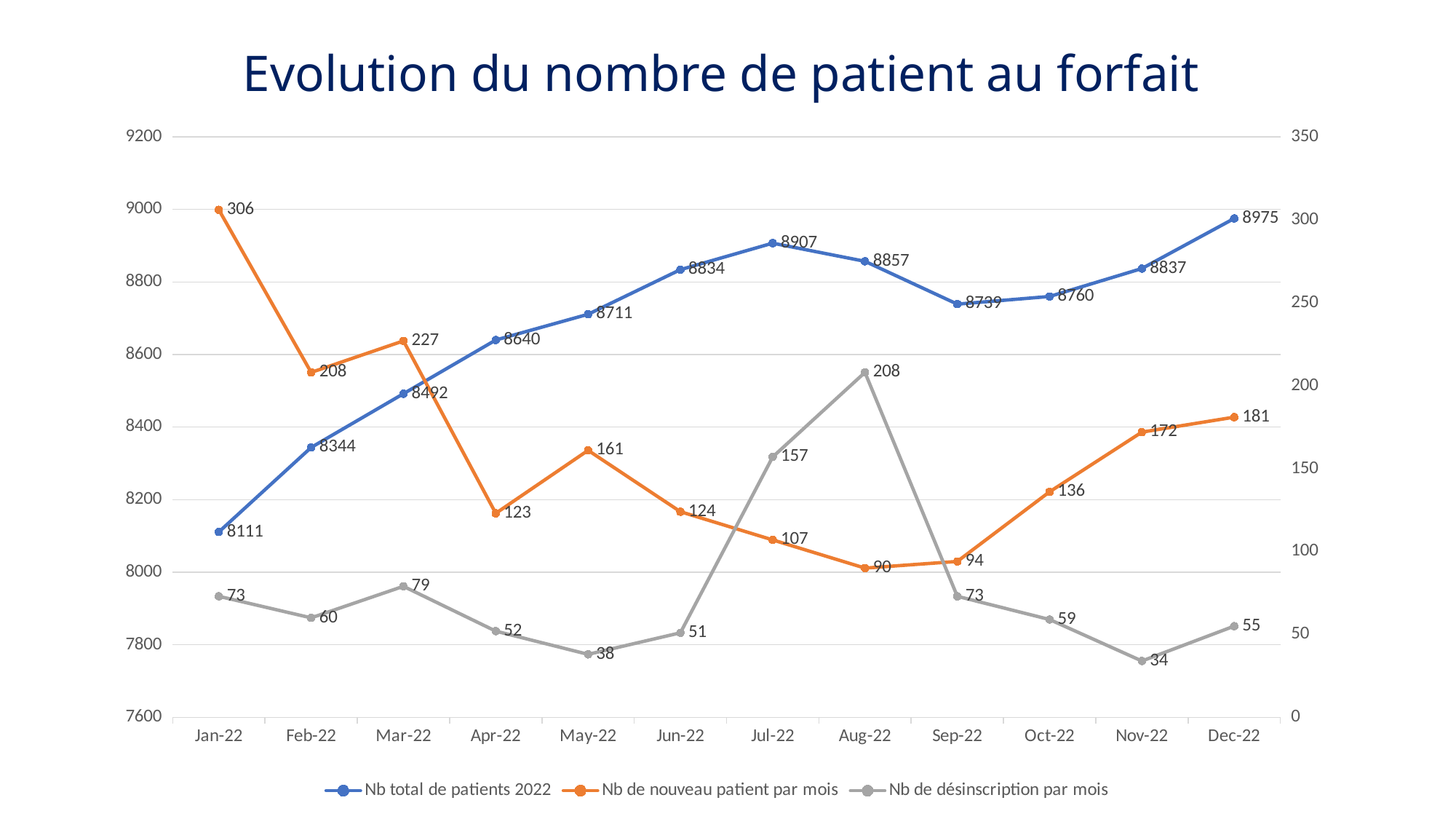
How many series does the legend list? 3 What is the title of the chart? Evolution du nombre de patient au forfait In which month is 'Nb de nouveau patient par mois' highest? Jan-22 How many months are plotted on the x axis? 12 What is the value of 'Nb de nouveau patient par mois' for Mar-22? 227 What is the difference between 'Nb total de patients 2022' in Dec-22 and Jan-22? 864 In which month is 'Nb de désinscription par mois' lowest? Nov-22 In which month is 'Nb total de patients 2022' lowest? Jan-22 Which is larger in Sep-22: 'Nb de nouveau patient par mois' or 'Nb de désinscription par mois'? Nb de nouveau patient par mois What is the value of 'Nb total de patients 2022' for Jul-22? 8907 What is the value of 'Nb de désinscription par mois' for Aug-22? 208 What kind of chart is shown on the slide? Line chart